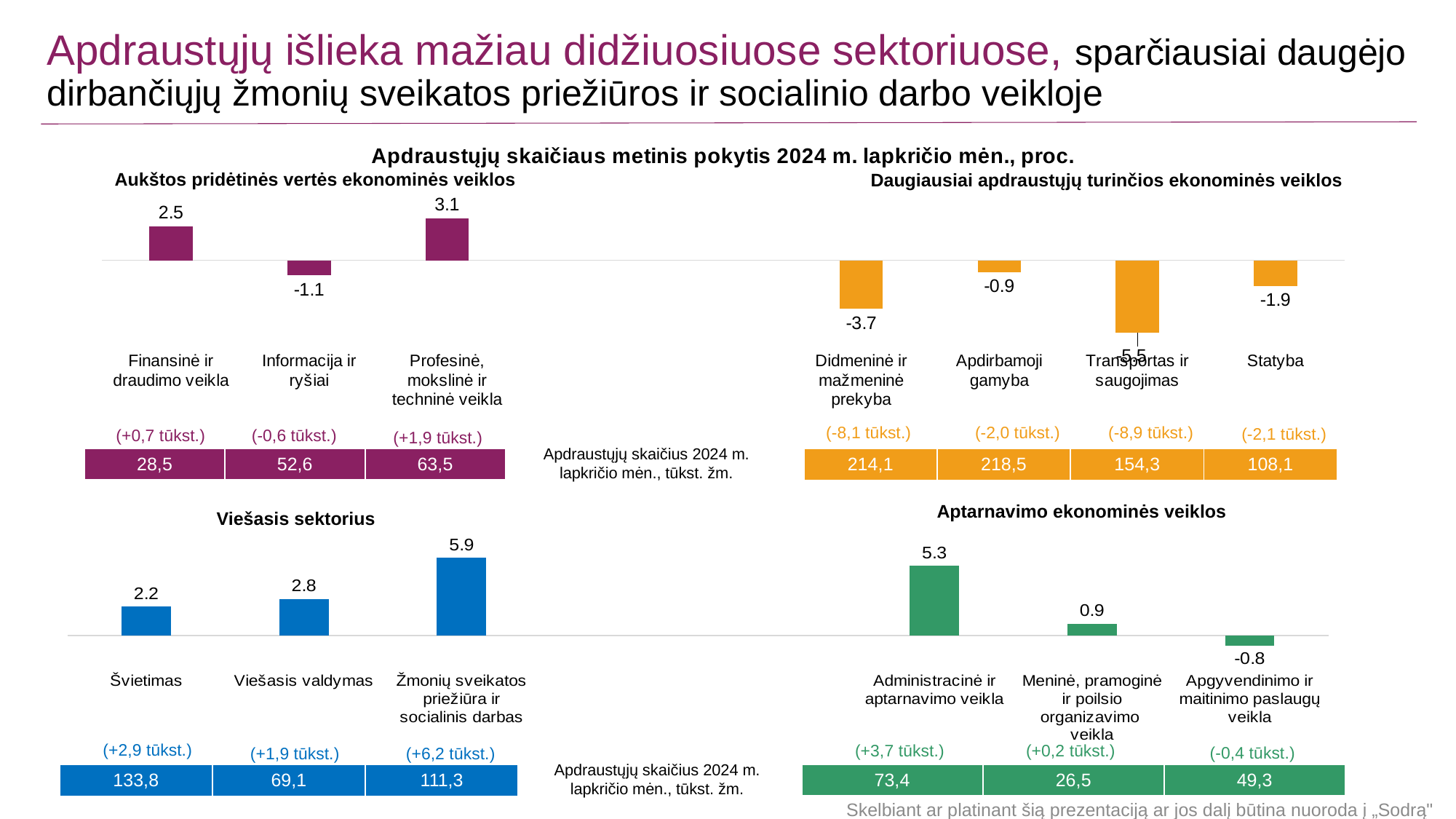
How many categories are shown in the 'Viešasis sektorius' chart? 3 How many categories are shown in the 'Daugiausiai apdraustųjų turinčios ekonominės veiklos' chart? 4 What type of chart is the 'Aptarnavimo ekonominės veiklos' chart? Bar chart In the 'Aptarnavimo ekonominės veiklos' chart, which is larger: the value for Administracinė ir aptarnavimo veikla or for Meninė, pramoginė ir poilsio organizavimo veikla? Administracinė ir aptarnavimo veikla In the 'Daugiausiai apdraustųjų turinčios ekonominės veiklos' chart, what is the value for Didmeninė ir mažmeninė prekyba? -3.7 In the 'Viešasis sektorius' chart, do the values rise or fall from left to right? Rise In the 'Aukštos pridėtinės vertės ekonominės veiklos' chart, which category has the highest value? Profesinė, mokslinė ir techninė veikla In the 'Aptarnavimo ekonominės veiklos' chart, what is the value for Apgyvendinimo ir maitinimo paslaugų veikla? -0.8 In the 'Viešasis sektorius' chart, what is the difference between the values for Žmonių sveikatos priežiūra ir socialinis darbas and Švietimas? 3.7 In the 'Viešasis sektorius' chart, what is the value for Žmonių sveikatos priežiūra ir socialinis darbas? 5.9 In the 'Daugiausiai apdraustųjų turinčios ekonominės veiklos' chart, which category has the lowest value? Transportas ir saugojimas In the 'Aukštos pridėtinės vertės ekonominės veiklos' chart, what is the value for Informacija ir ryšiai? -1.1